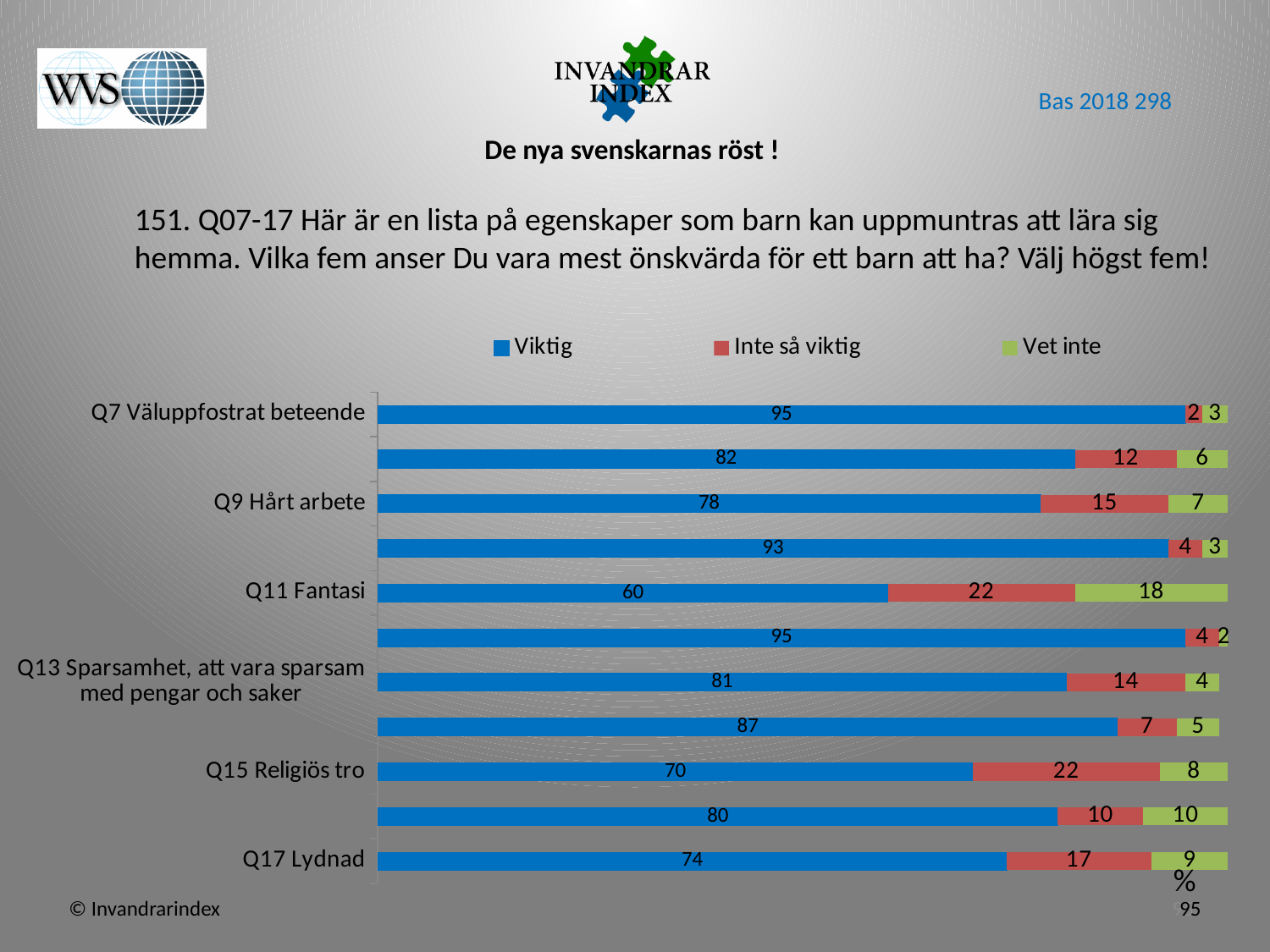
Which has a larger 'Inte så viktig' value, Q9 Hårt arbete or Q13 Sparsamhet, att vara sparsam med pengar och saker? Q9 Hårt arbete What is the 'Viktig' value for Q9 Hårt arbete? 78 What is the 'Inte så viktig' value for Q17 Lydnad? 17 Which category has the lowest 'Viktig' value? Q11 Fantasi How many series does the legend list? 3 What kind of chart is shown on the slide? Stacked bar chart What is the 'Viktig' value for Q11 Fantasi? 60 How many bars are plotted in the chart? 11 Which category has the highest 'Vet inte' value? Q11 Fantasi What is the difference between the 'Viktig' values for Q7 Väluppfostrat beteende and Q17 Lydnad? 21 What is the total of the stacked bar for Q15 Religiös tro? 100 What is the 'Vet inte' value for Q15 Religiös tro? 8